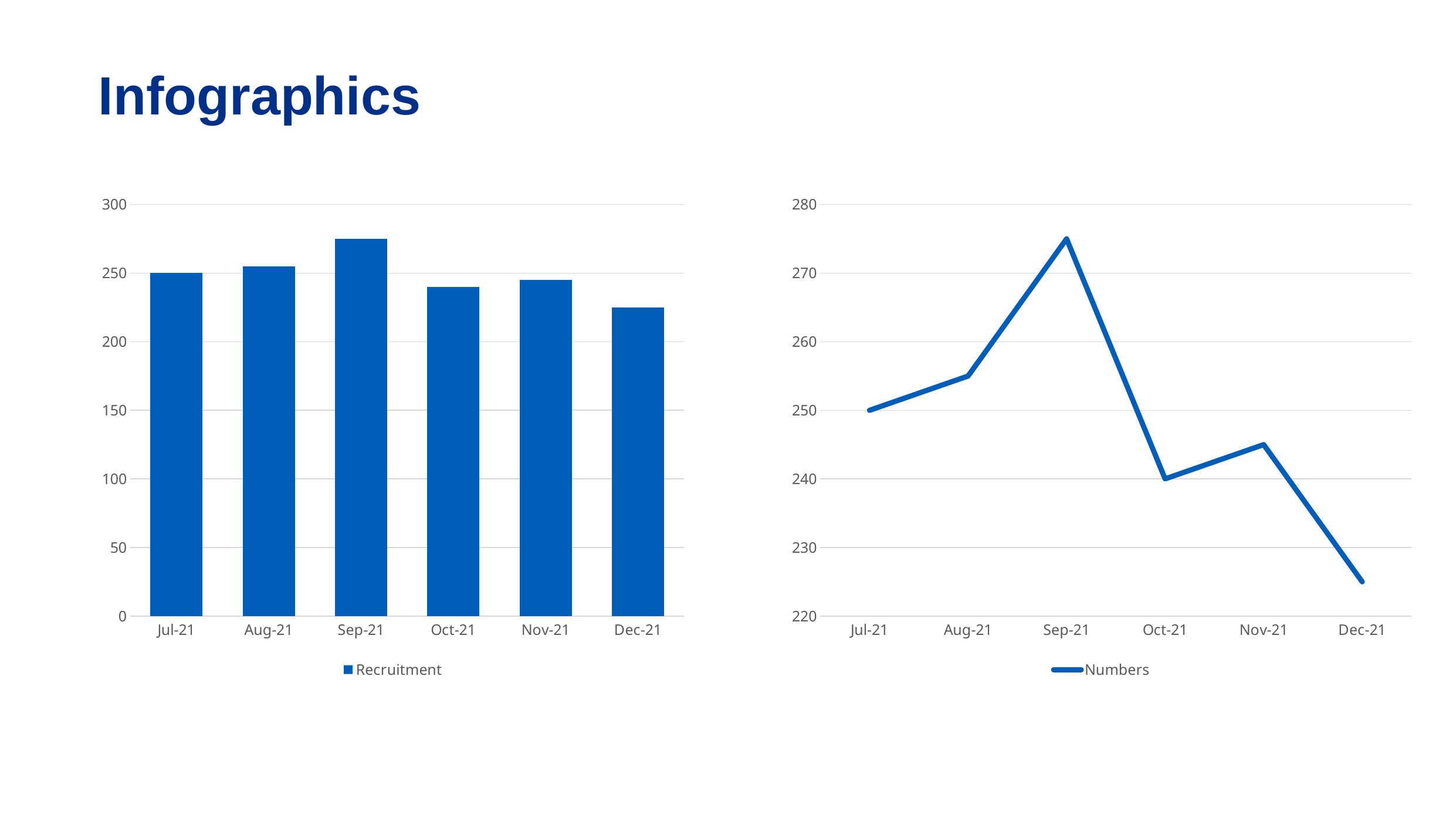
On the left bar chart, what is the Recruitment value for Jul-21? 250 On the left bar chart, is the Recruitment value for Sep-21 greater or less than 250? greater What kind of chart is the chart on the left of the slide? Bar chart What is the legend entry of the chart on the left of the slide? Recruitment On the right line chart, does the Numbers value rise or fall from Sep-21 to Dec-21? Fall On the left bar chart, which is larger: the Recruitment value for Aug-21 or for Oct-21? Aug-21 On the right line chart, is the Numbers value for Dec-21 greater or less than 230? less On the right line chart, what is the Numbers value for Oct-21? 240 On the right line chart, how many series does the legend list? 1 On the left bar chart, how many months are shown on the x axis? 6 On the left bar chart, which month has the highest Recruitment value? Sep-21 On the right line chart, which month has the lowest Numbers value? Dec-21